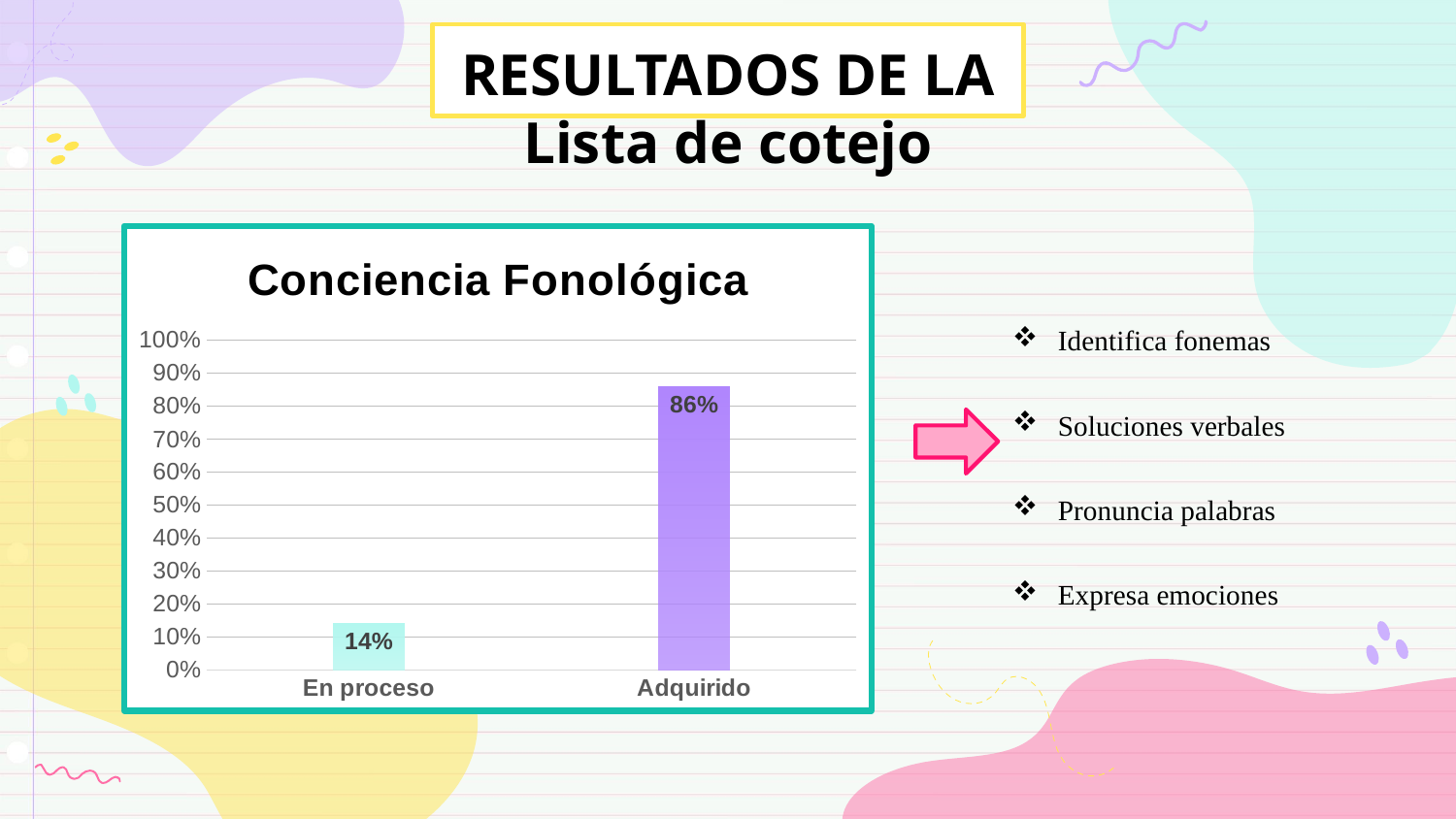
What is the value for Adquirido? 86% Is the value for Adquirido greater or less than 50%? greater What kind of chart is shown? bar chart What is the value for En proceso? 14% Which is larger, the value for En proceso or the value for Adquirido? Adquirido Which category has the lowest value? En proceso How many categories are shown on the x axis? 2 What is the title of the chart? Conciencia Fonológica What is the highest value shown on the y axis? 100% What is the difference between the values for Adquirido and En proceso? 72% Which category has the highest value? Adquirido Is the value for En proceso greater or less than 20%? less